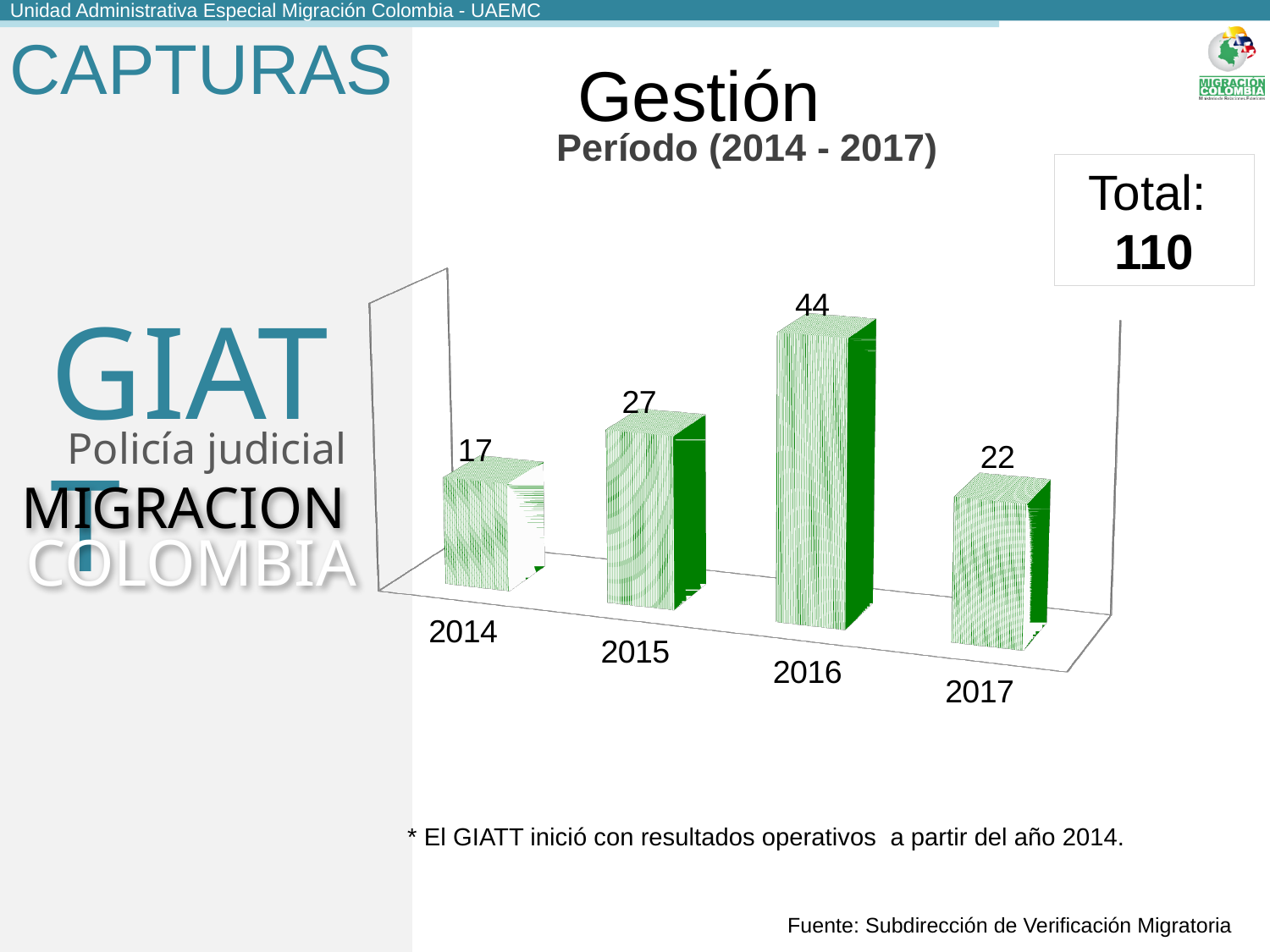
What period does the chart title say it covers? 2014 - 2017 What is the difference between the values for 2016 and 2015? 17 What is the value for 2016? 44 Which is larger, the value for 2015 or the value for 2017? 2015 What kind of chart is this? bar chart Which year has the highest value? 2016 What is the value for 2017? 22 What is the difference between the values for 2017 and 2014? 5 How many years are shown on the chart? 4 What is the value for 2014? 17 What total is shown in the box next to the chart? 110 Which year has the lowest value? 2014